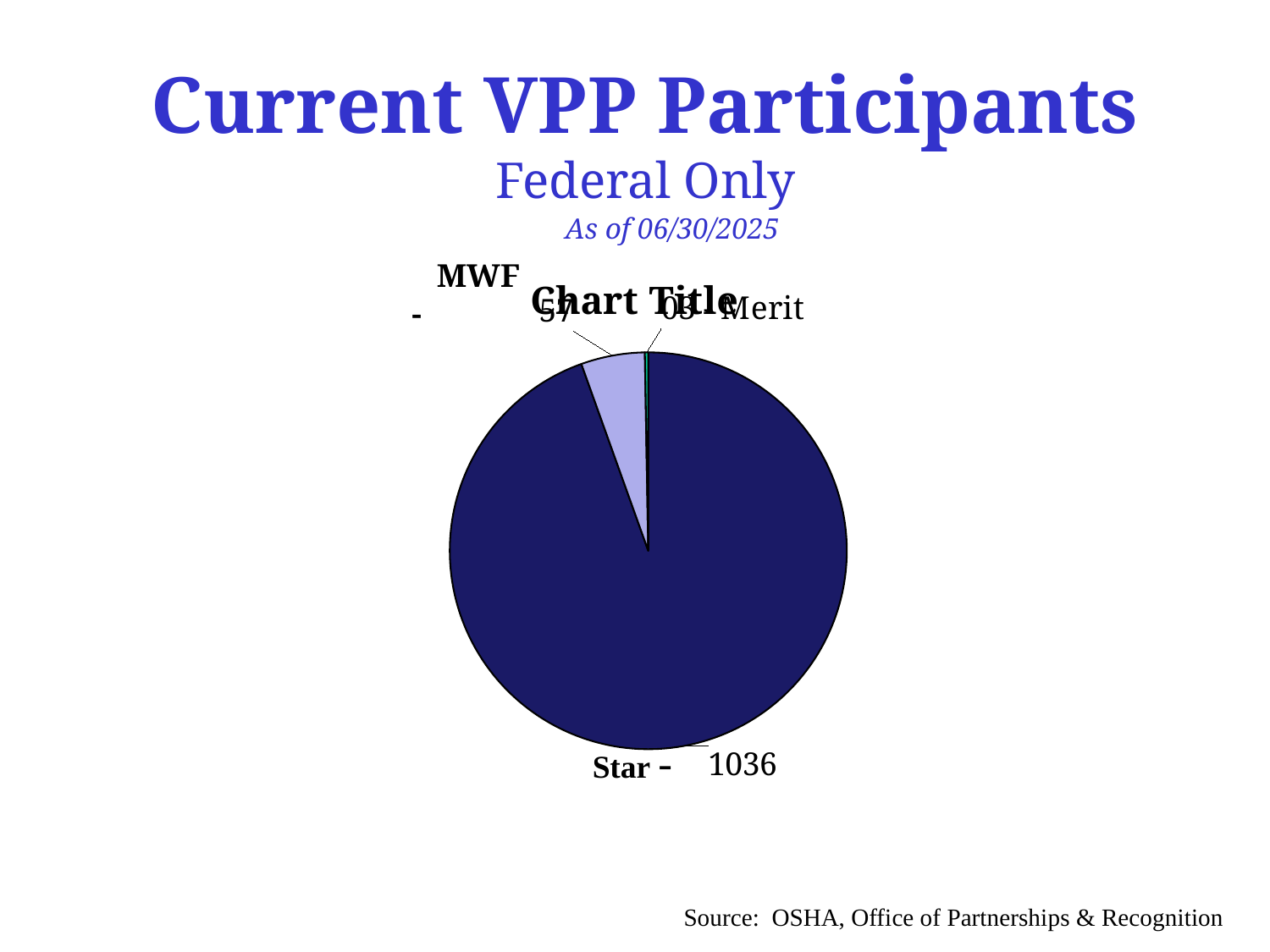
Which category has the largest slice of the pie? Star How many participants are in the MWF category? 57 What is the difference between the Star value and the MWF value? 979 How many participants are in the Star category? 1036 Which is larger, the Star value or the MWF value? Star How many categories (slices) does the pie chart have? 3 What date is the data on the slide current as of? 06/30/2025 What kind of chart is shown on the slide? pie chart What is the title printed directly above the pie chart? Chart Title Which category has the smallest slice of the pie? Merit